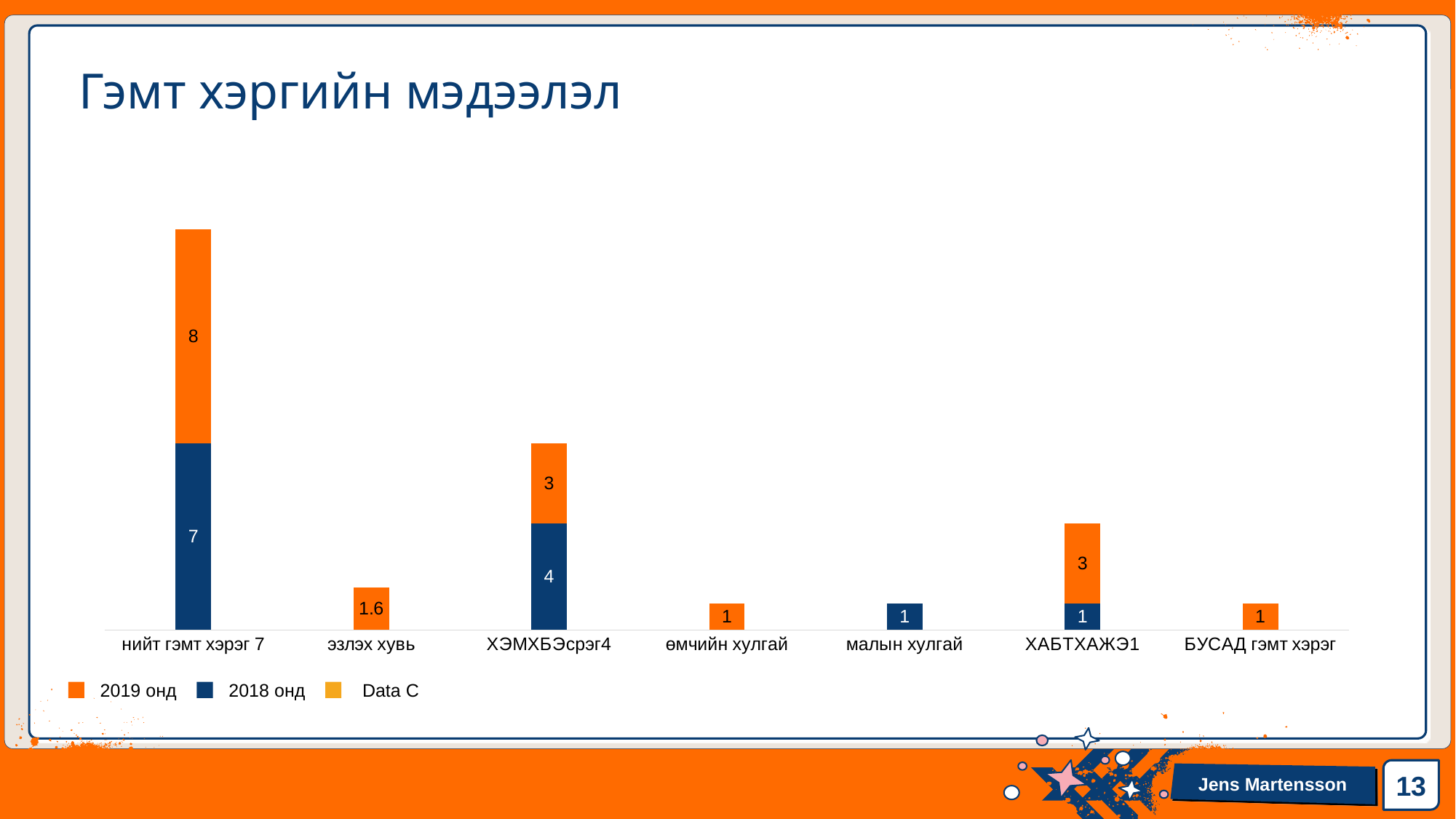
What is the 2018 онд value for ХАБТХАЖЭ1? 1 What is the total of the stacked bar for ХЭМХБЭсрэг4? 7 What type of chart is shown on the slide? Stacked bar chart How many categories are shown on the x axis? 7 Which category has the tallest stacked bar? нийт гэмт хэрэг 7 What is the difference between the 2019 онд and 2018 онд values for ХАБТХАЖЭ1? 2 What is the 2018 онд value for ХЭМХБЭсрэг4? 4 What is the total of the stacked bar for нийт гэмт хэрэг 7? 15 Which is larger for ХЭМХБЭсрэг4: the 2019 онд value or the 2018 онд value? 2018 онд What is the 2019 онд value for нийт гэмт хэрэг 7? 8 How many series does the legend list? 3 What is the 2019 онд value for эзлэх хувь? 1.6